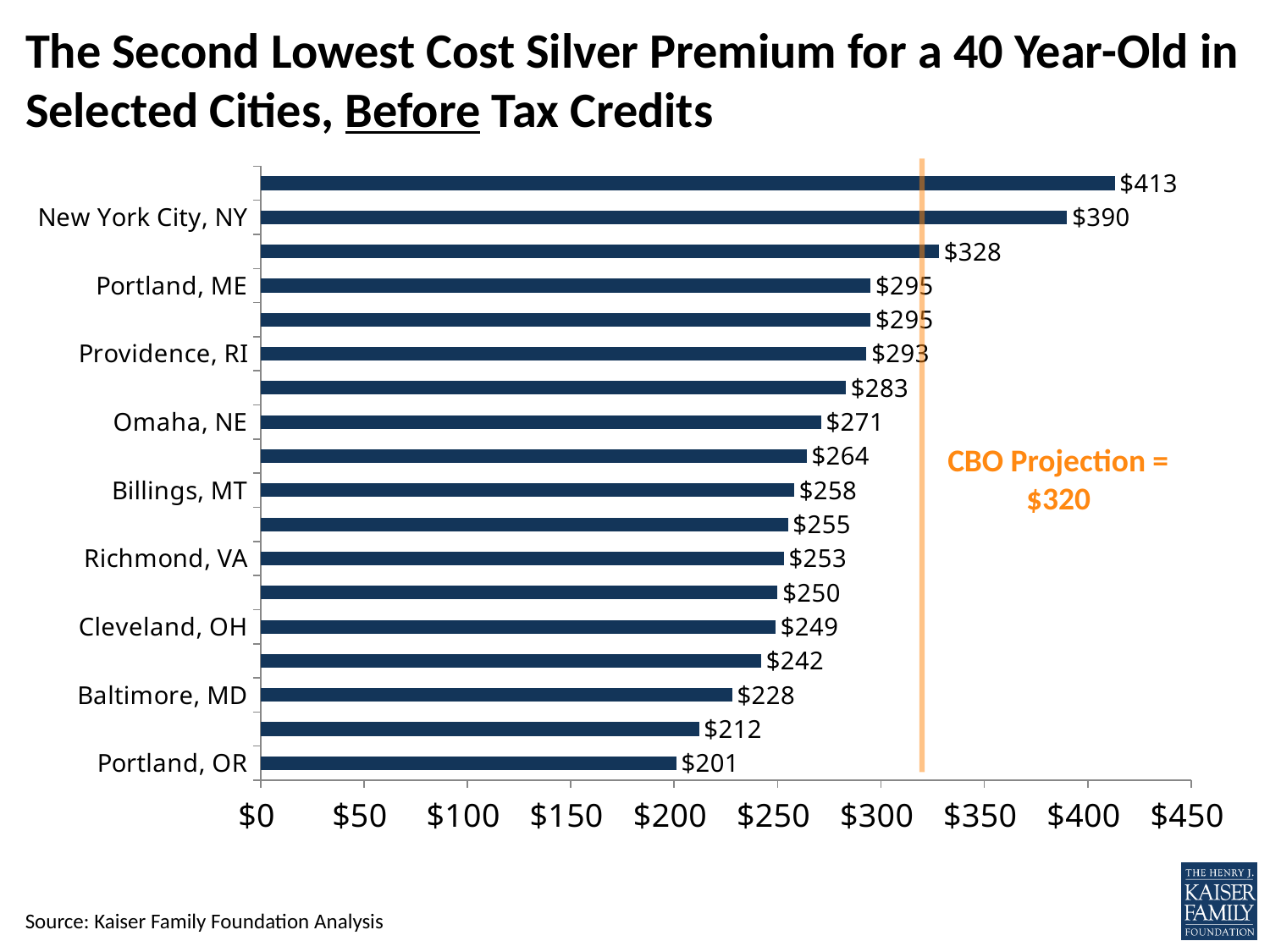
What is the second lowest cost silver premium for a 40 year-old in New York City, NY? $390 What is the difference between the premiums for Portland, ME and Providence, RI? $2 What is the premium value shown for Baltimore, MD? $228 What is the premium value shown for Omaha, NE? $271 What is the highest premium value shown on the chart? $413 Which has a higher premium, Billings, MT or Richmond, VA? Billings, MT What value does the orange vertical line labeled CBO Projection mark? $320 What is the premium value shown for Portland, OR? $201 Is the premium for Cleveland, OH greater or less than $300? less Which labeled city has the lowest premium on the chart? Portland, OR What is the difference between the premiums for New York City, NY and Portland, OR? $189 How many bars are plotted on the chart? 18